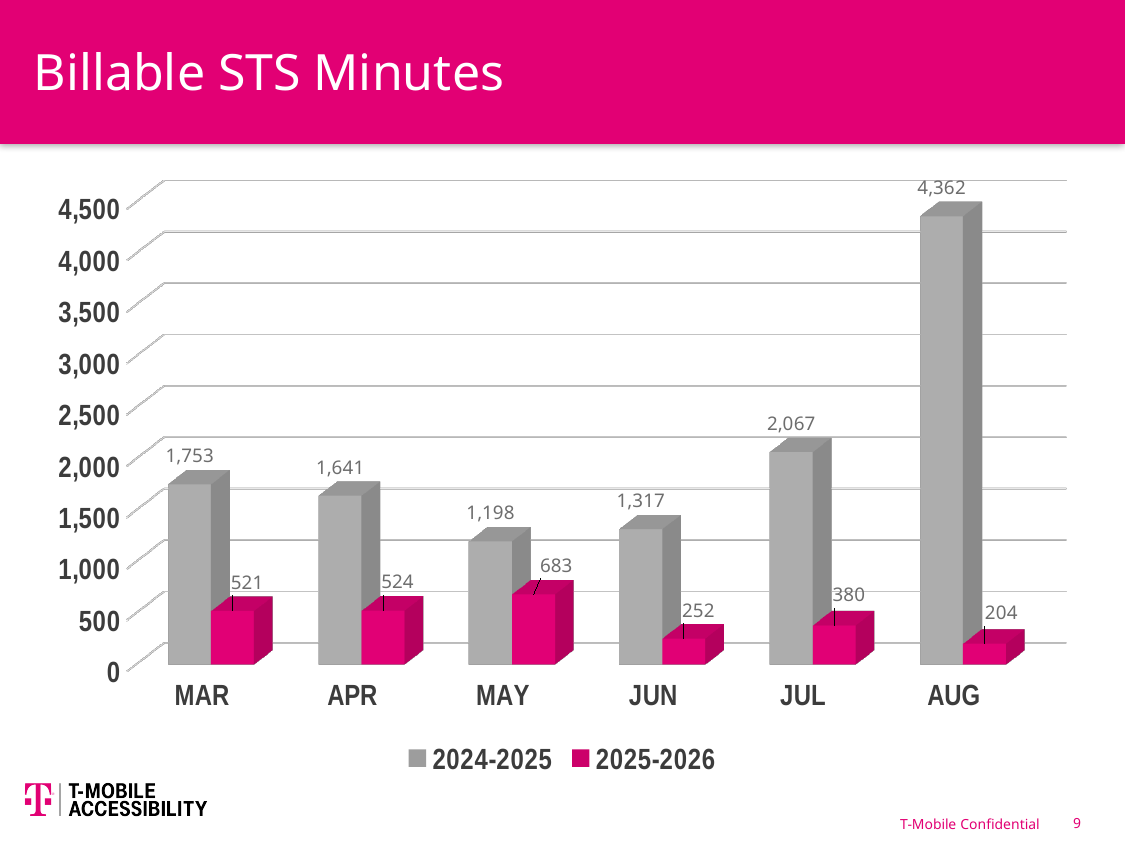
What kind of chart is shown on the slide? bar chart What is the value for 2024-2025 in JUN? 1,317 Which is larger, the 2025-2026 value in APR or the 2025-2026 value in JUL? APR What is the title of the chart? Billable STS Minutes How many months are shown on the x axis? 6 What is the value for 2025-2026 in MAY? 683 What is the difference between the 2024-2025 and 2025-2026 values in MAR? 1,232 How many series does the legend list? 2 Is the value for 2024-2025 in JUL greater or less than 2,000? greater Which month has the highest value for the 2024-2025 series? AUG What is the value for 2024-2025 in AUG? 4,362 Which month has the lowest value for the 2025-2026 series? AUG